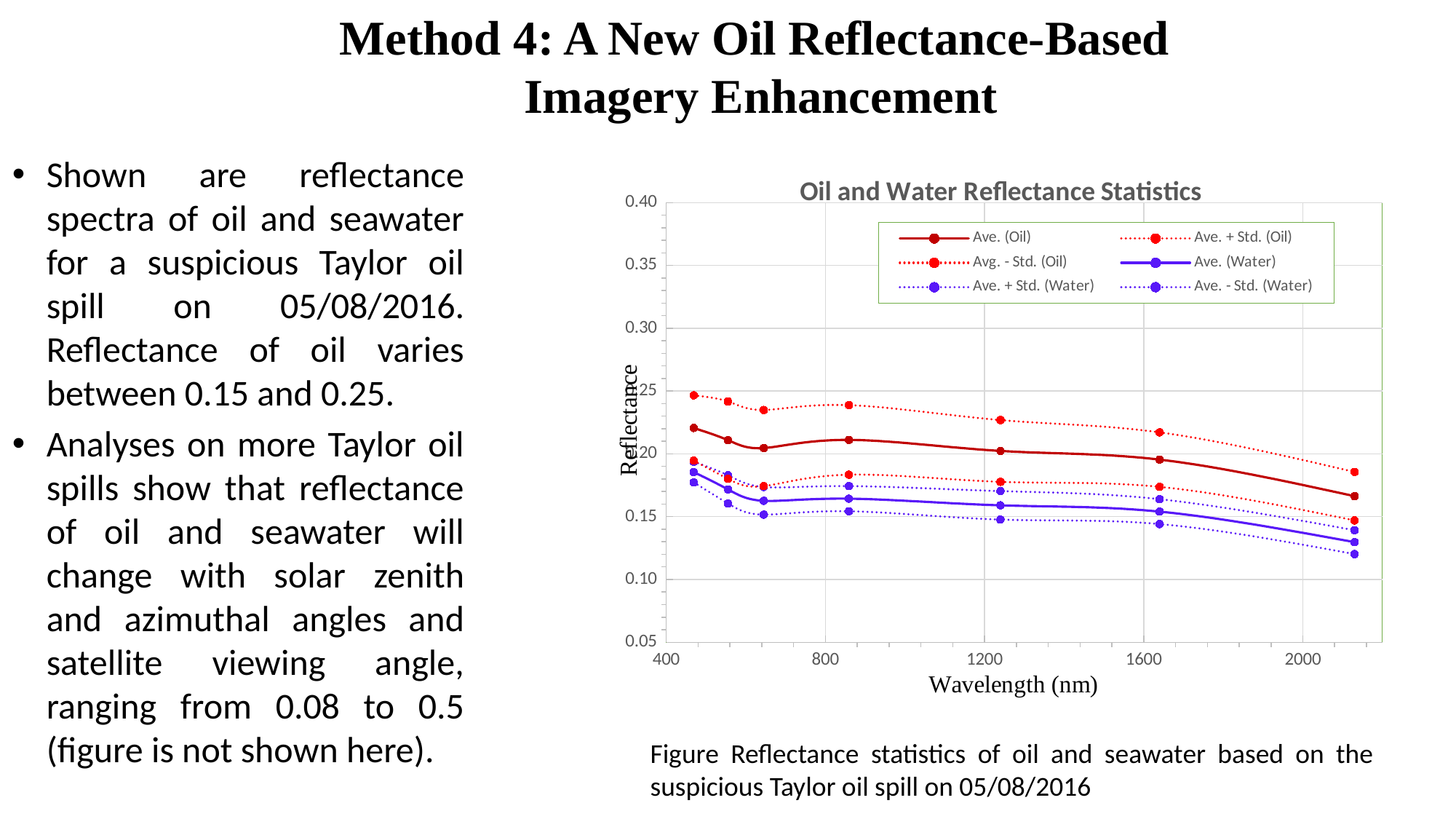
Does the Ave. (Oil) series generally rise or fall as wavelength increases? fall How many data points are plotted for the Ave. (Oil) series? 7 How many series does the legend of the chart list? 6 At a wavelength of about 1600 nm, which is larger: the Ave. (Oil) reflectance or the Ave. (Water) reflectance? Ave. (Oil) Which series has the highest reflectance values across the wavelengths? Ave. + Std. (Oil) At the shortest wavelength plotted, is the Ave. (Oil) reflectance greater or less than 0.20? greater Does the Ave. (Water) series generally rise or fall as wavelength increases? fall What is the label of the x axis of the chart? Wavelength (nm) What kind of chart is shown on the slide? line chart At the longest wavelength plotted, is the Ave. (Water) reflectance greater or less than 0.15? less What is the title of the chart? Oil and Water Reflectance Statistics Which series has the lowest reflectance values across the wavelengths? Ave. - Std. (Water)